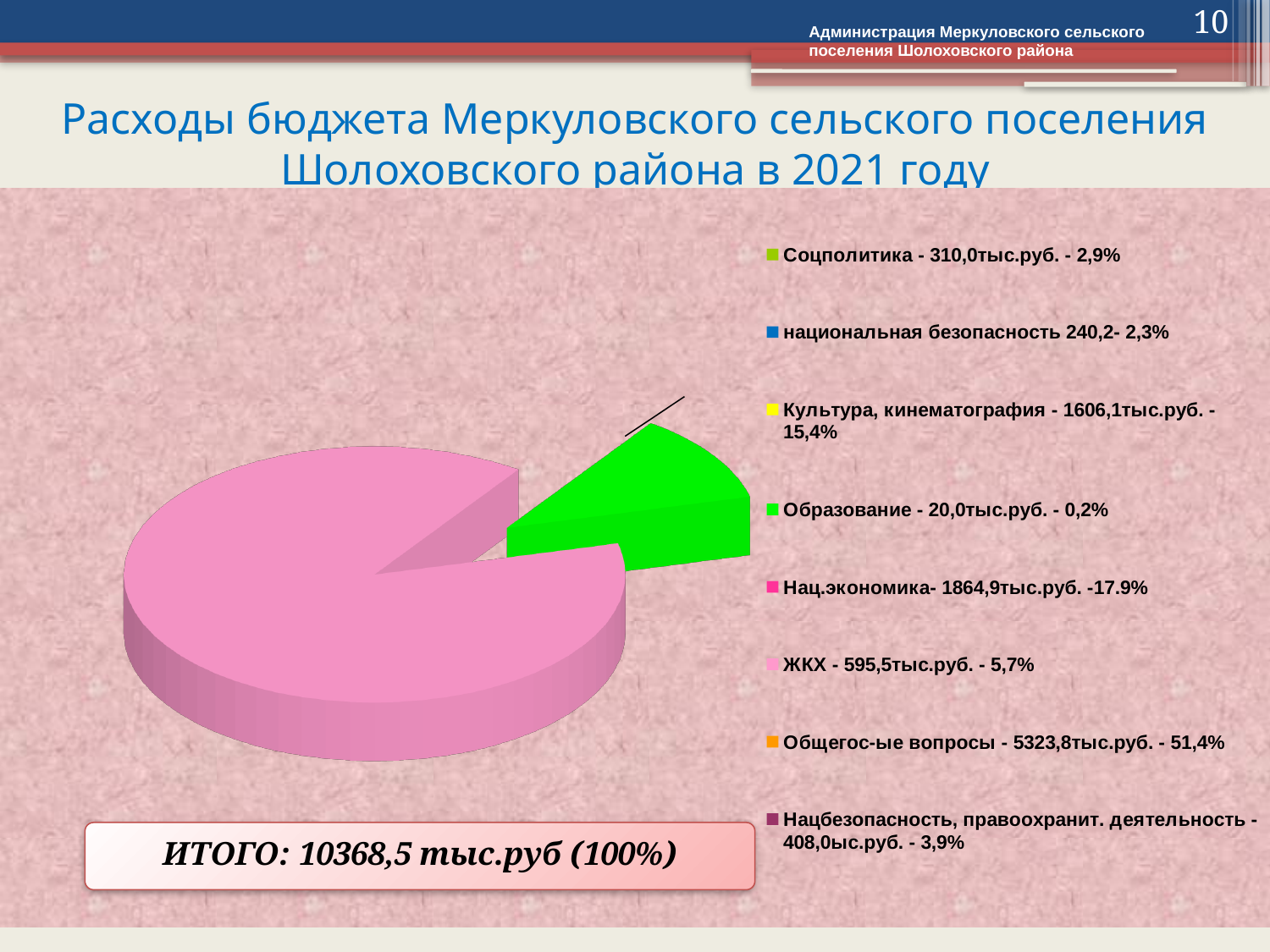
What is the amount for Нац.экономика? 1864,9тыс.руб. What share of the budget does Культура, кинематография account for? 15,4% What is the total budget expenditure (ИТОГО) shown on the slide? 10368,5 тыс.руб (100%) Which category has the highest value in the legend? Общегос-ые вопросы Which is larger, the value for ЖКХ or the value for Нацбезопасность, правоохранит. деятельность? ЖКХ How many categories does the legend of the pie chart list? 8 What is the value for Соцполитика according to the legend? 310,0тыс.руб. - 2,9% What share of the budget does Общегос-ые вопросы account for? 51,4% Which category has the lowest value in the legend? Образование What is the title of the slide containing the chart? Расходы бюджета Меркуловского сельского поселения Шолоховского района в 2021 году What kind of chart is shown on the slide? pie chart What is the difference in percentage share between Нац.экономика and Культура, кинематография? 2,5%